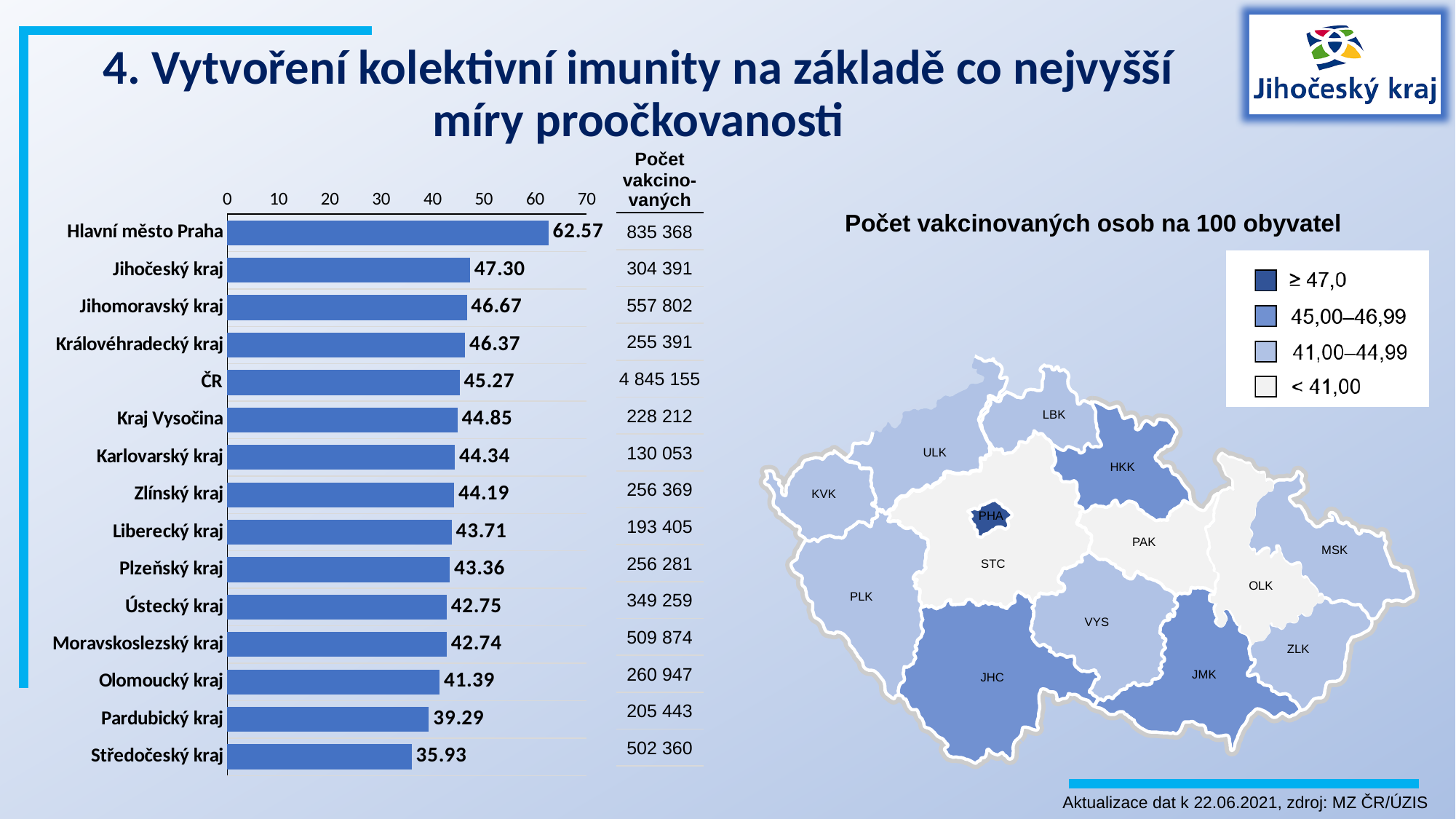
In the bar chart, is the value for Hlavní město Praha greater or less than 60? greater In the bar chart, what is the value for Jihočeský kraj? 47.30 What is the title printed above the map on the right of the slide? Počet vakcinovaných osob na 100 obyvatel In the bar chart, which is larger: the value for Jihočeský kraj or the value for Jihomoravský kraj? Jihočeský kraj In the bar chart, what is the value for Středočeský kraj? 35.93 Which category has the lowest value in the bar chart? Středočeský kraj In the bar chart, what is the value for ČR? 45.27 In the bar chart, what is the difference between the values for Hlavní město Praha and Jihočeský kraj? 15.27 In the bar chart, what is the difference between the values for Jihočeský kraj and ČR? 2.03 How many bars are shown in the bar chart? 15 What kind of chart is shown on the left of the slide? bar chart Which category has the highest value in the bar chart? Hlavní město Praha